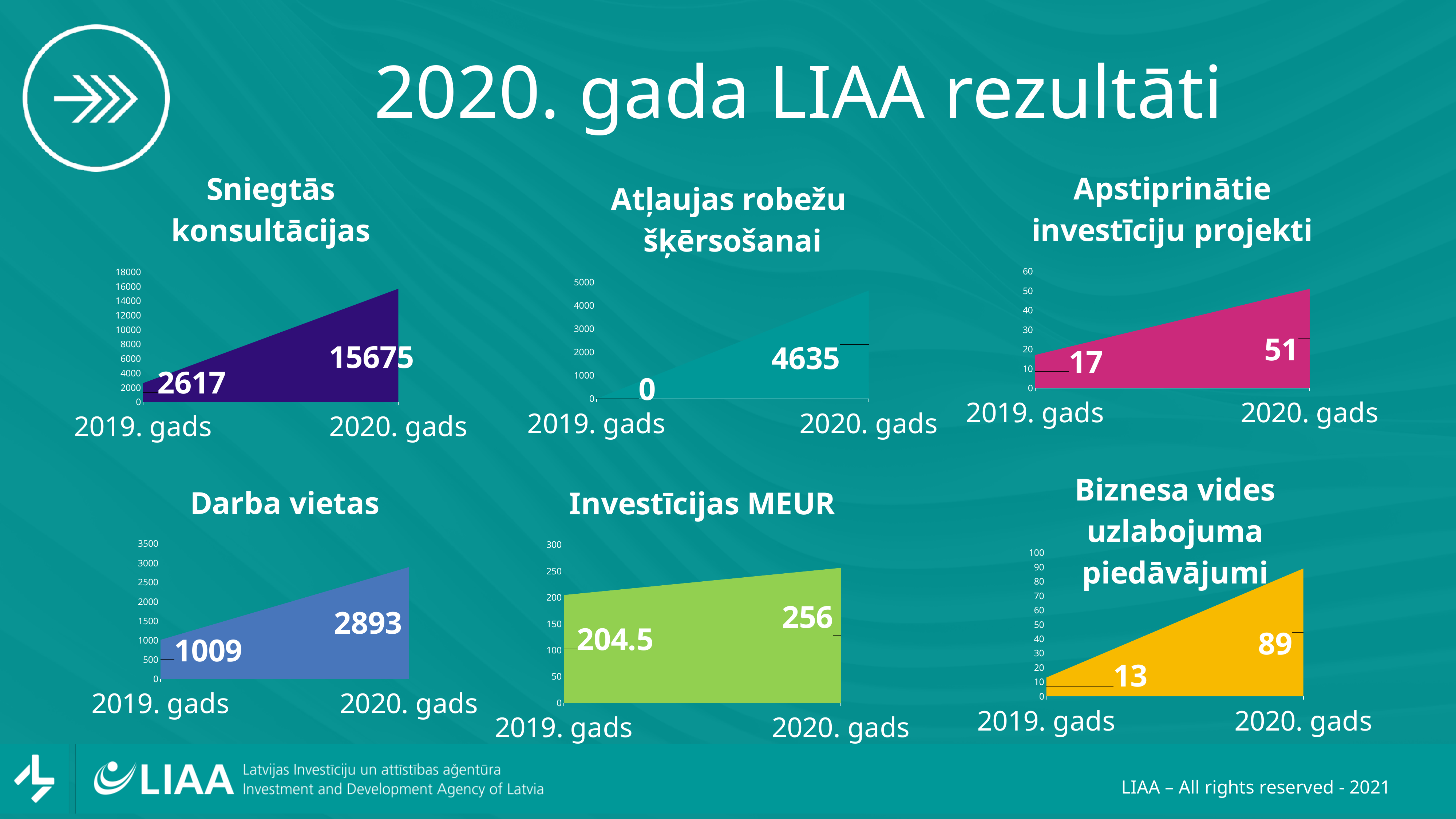
In the 'Darba vietas' chart, do the values rise or fall from 2019. gads to 2020. gads? rise In the 'Investīcijas MEUR' chart, what is the value for 2019. gads? 204.5 How many charts are shown on the slide? 6 In the 'Sniegtās konsultācijas' chart, what is the value for 2020. gads? 15675 In the 'Atļaujas robežu šķērsošanai' chart, what is the value for 2020. gads? 4635 In the 'Darba vietas' chart, what is the value for 2019. gads? 1009 What type of chart is the 'Atļaujas robežu šķērsošanai' chart? area chart In the 'Sniegtās konsultācijas' chart, what is the value for 2019. gads? 2617 In the 'Biznesa vides uzlabojuma piedāvājumi' chart, what is the difference between the 2020. gads and 2019. gads values? 76 In the 'Apstiprinātie investīciju projekti' chart, what is the difference between the 2020. gads and 2019. gads values? 34 In the 'Investīcijas MEUR' chart, which year has the larger value, 2019. gads or 2020. gads? 2020. gads In the 'Biznesa vides uzlabojuma piedāvājumi' chart, what is the value for 2020. gads? 89